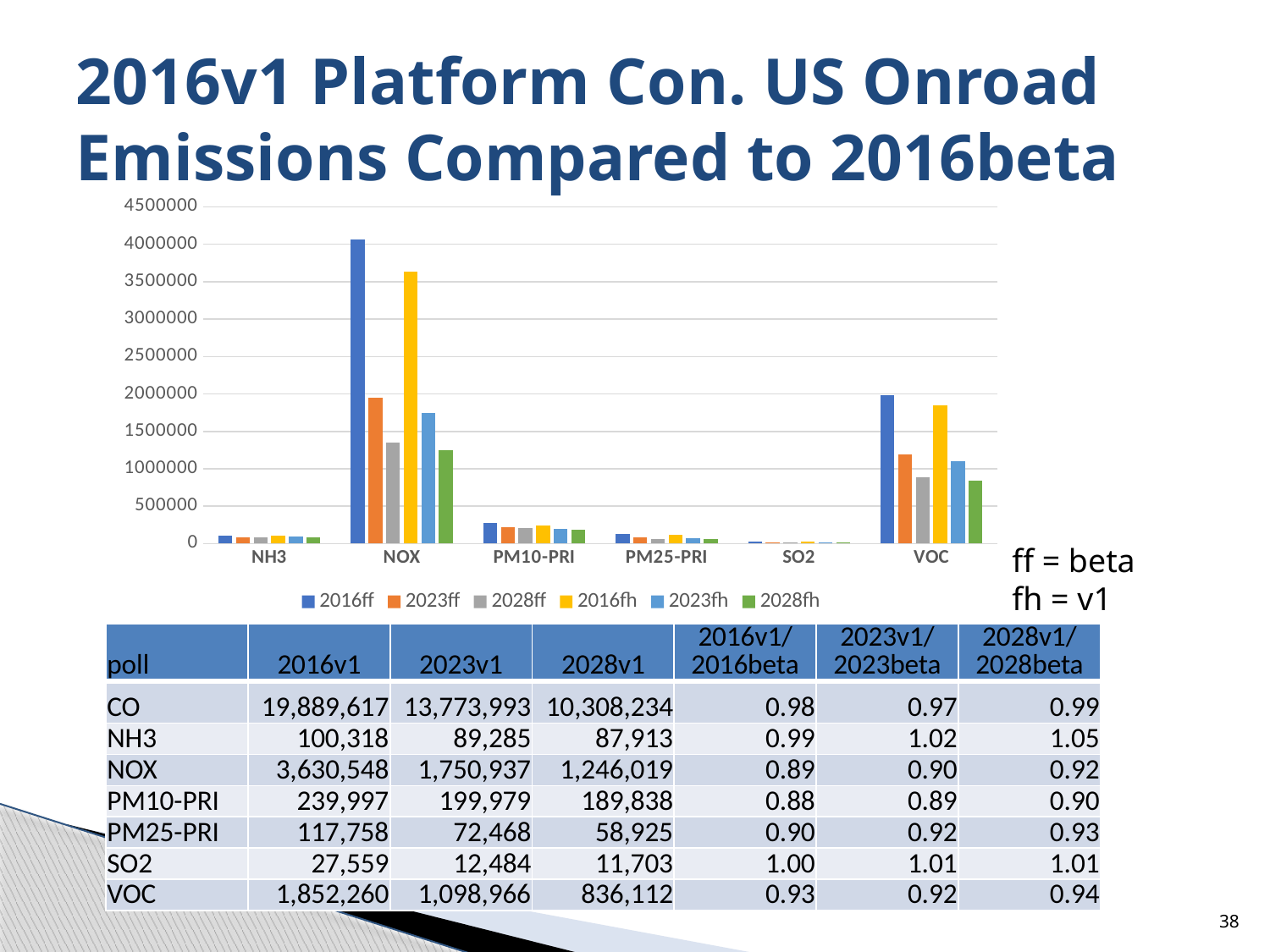
Is the 2028fh value for VOC greater or less than 1000000? less Is the 2016ff value for VOC greater or less than 1500000? greater For NOX, which is larger: the 2016ff bar or the 2016fh bar? 2016ff Is the 2016ff value for NOX greater or less than 3500000? greater Which pollutant category has the tallest bar in the chart? NOX What kind of chart is shown on the slide? bar chart Which pollutant category has the smallest bars in the chart? SO2 How many series does the chart legend list? 6 According to the note beside the legend, what does 'fh' stand for? v1 How many pollutant categories are shown on the x axis of the chart? 6 For the 2016ff series, which is larger: NOX or VOC? NOX